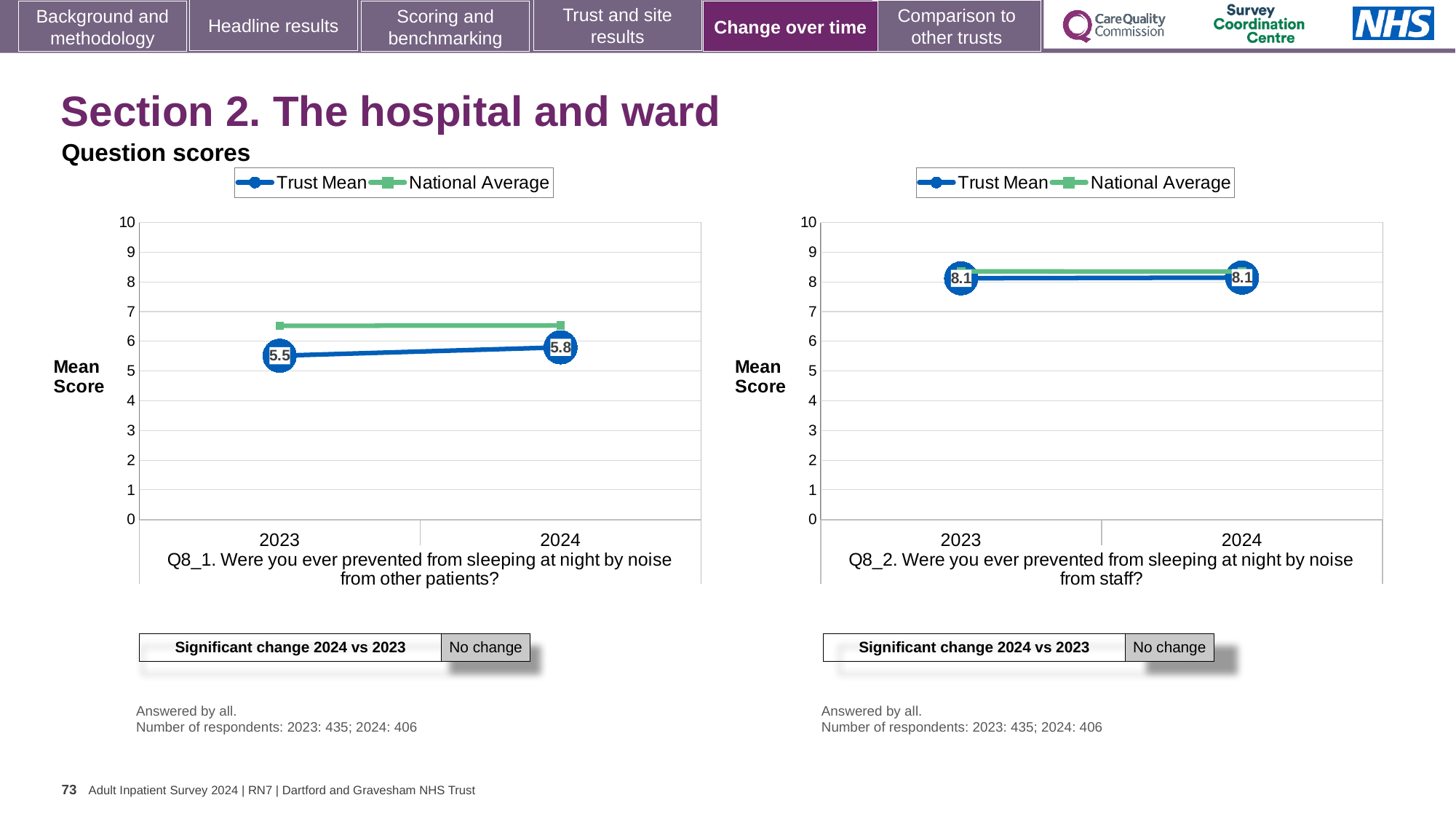
On the right chart (Q8_2), is the National Average value for 2024 greater or less than 9? less On the left chart (Q8_1), which year has the higher Trust Mean, 2023 or 2024? 2024 On the left chart (Q8_1), does the Trust Mean rise or fall from 2023 to 2024? rise On the right chart (Q8_2), what is the Trust Mean score for 2024? 8.1 How many series does the legend of the right chart (Q8_2) list? 2 How many years are plotted on the x axis of the left chart (Q8_1)? 2 On the left chart (Q8_1), what is the Trust Mean score for 2024? 5.8 On the left chart (Q8_1), by how much did the Trust Mean change from 2023 to 2024? 0.3 What kind of chart is the left chart (Q8_1)? line chart On the left chart (Q8_1), what is the Trust Mean score for 2023? 5.5 On the right chart (Q8_2), does the Trust Mean rise, fall or stay the same from 2023 to 2024? stay the same On the left chart (Q8_1), is the National Average value for 2023 greater or less than 6? greater